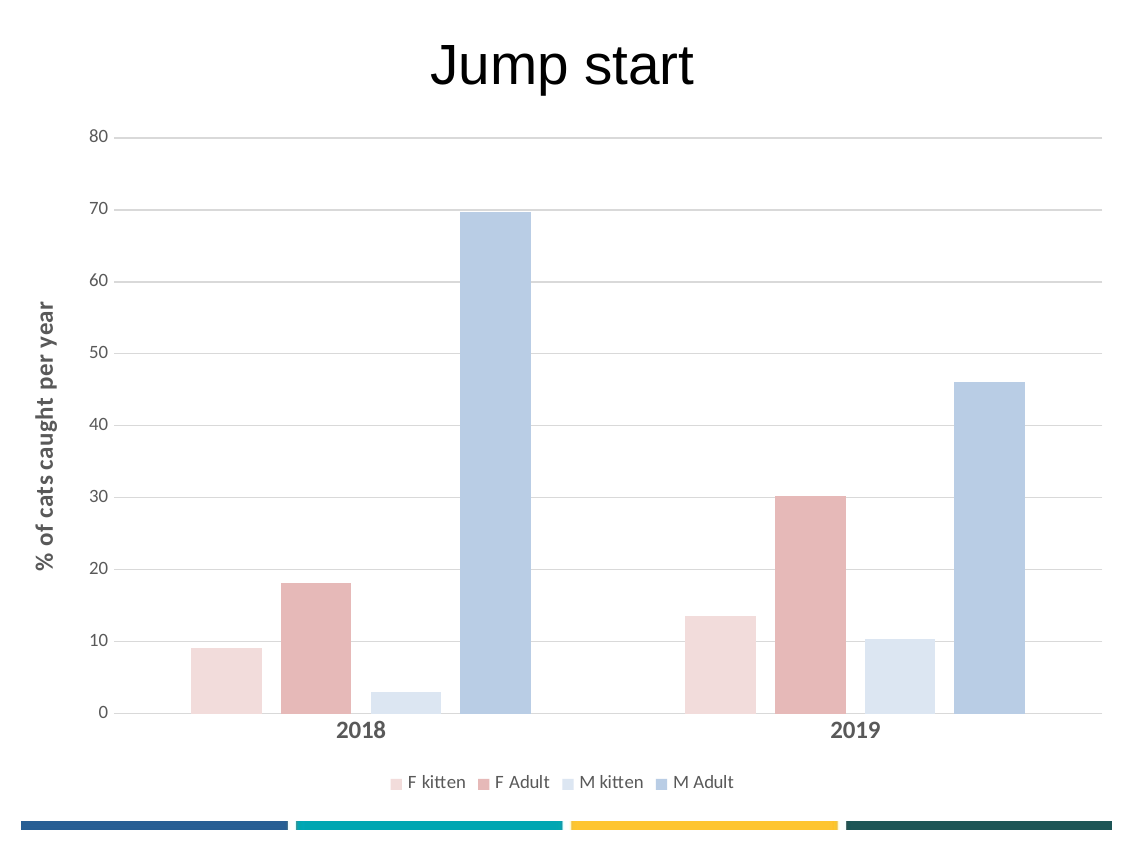
Which is larger, the F Adult value in 2018 or the F Adult value in 2019? 2019 Does the M Adult value rise or fall from 2018 to 2019? fall Is the value for M Adult in 2018 greater or less than 60? greater What kind of chart is shown on the slide? bar chart Is the value for M kitten in 2018 greater or less than 10? less Which series has the lowest value in 2018? M kitten How many series does the legend list? 4 How many year categories are shown on the x axis? 2 Is the value for F Adult in 2019 greater or less than 20? greater Which series has the highest value in 2018? M Adult Which series has the highest value in 2019? M Adult